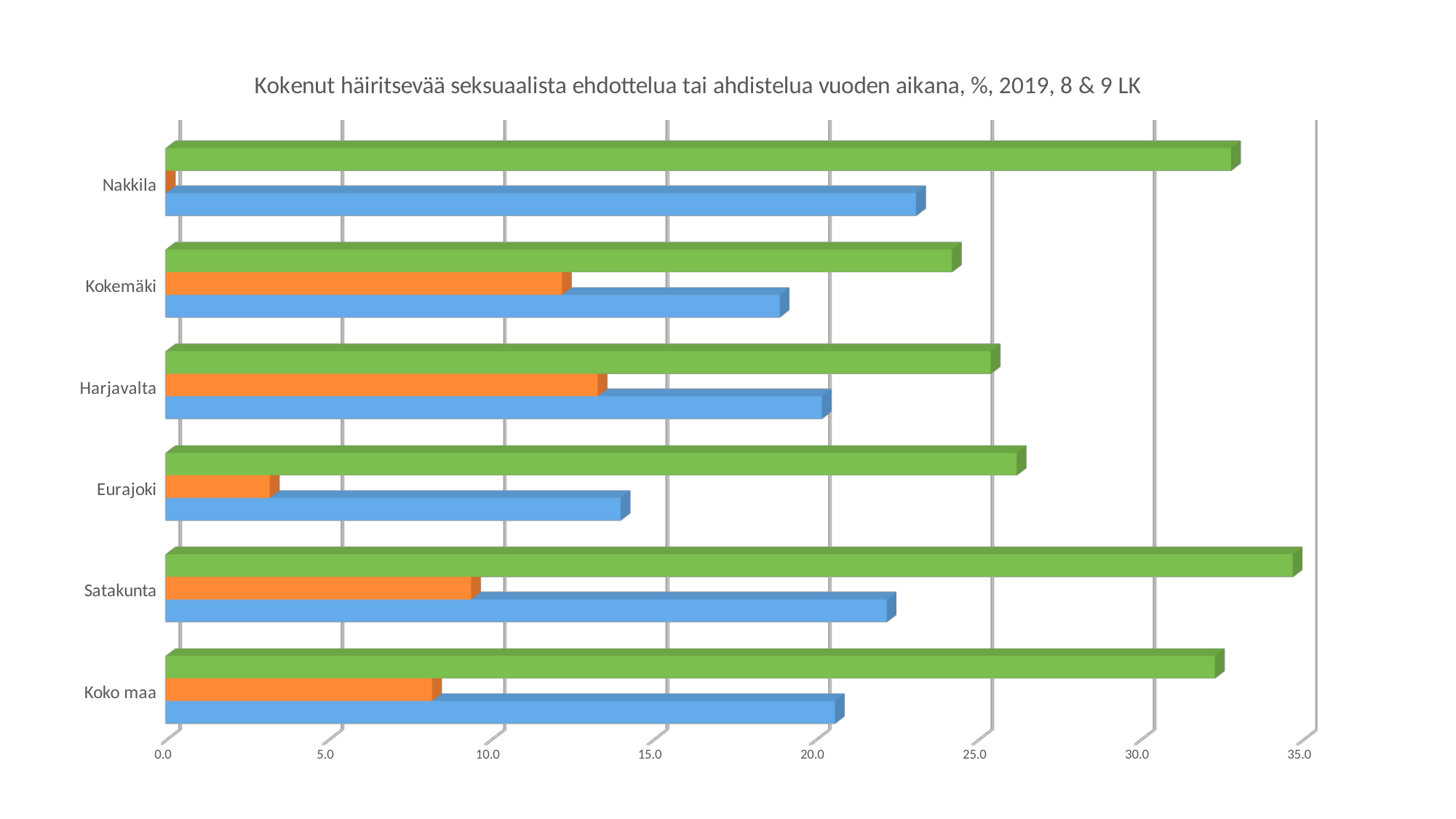
Which category has the shortest blue bar? Eurajoki Which is larger, the green bar for Nakkila or the green bar for Kokemäki? Nakkila Which category has the shortest orange bar? Nakkila Which category has the longest orange bar? Harjavalta Is the green bar for Nakkila greater or less than 30? greater What is the title of the chart? Kokenut häiritsevää seksuaalista ehdottelua tai ahdistelua vuoden aikana, %, 2019, 8 & 9 LK Is the blue bar for Eurajoki greater or less than 15? less How many bars are plotted for each category in the chart? 3 Which category has the longest green bar? Satakunta Is the orange bar for Kokemäki greater or less than 10? greater How many categories are shown on the vertical axis of the chart? 6 What kind of chart is shown on the slide? bar chart